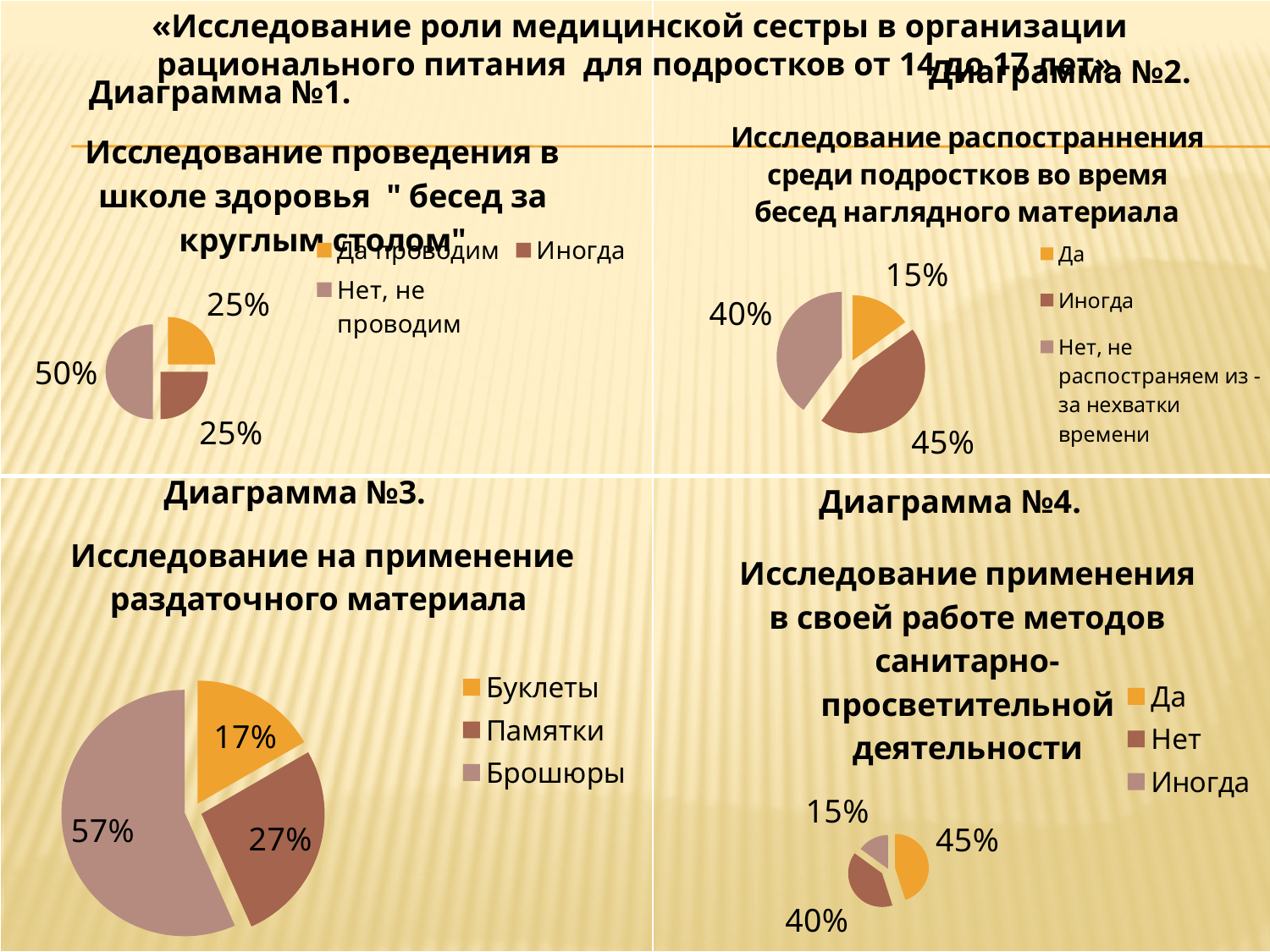
In Диаграмма №1, which category has the largest share? Нет, не проводим In Диаграмма №4 (санитарно-просветительной деятельности), what share is labelled "Да"? 45% In Диаграмма №2, which category has the smallest share? Да In Диаграмма №3 (раздаточного материала), what share is labelled "Брошюры"? 57% In Диаграмма №4, which category has the smallest share? Иногда In Диаграмма №3, which is larger: "Буклеты" or "Памятки"? Памятки In Диаграмма №3, what is the difference between "Брошюры" and "Памятки"? 30% In Диаграмма №2, what is the difference between the "Иногда" share and the "Да" share? 30% What type of chart is Диаграмма №4? Pie chart In Диаграмма №1 ("бесед за круглым столом"), what share is labelled "Нет, не проводим"? 50% How many series does the legend of Диаграмма №3 list? 3 In Диаграмма №2 (наглядного материала), what share is labelled "Иногда"? 45%